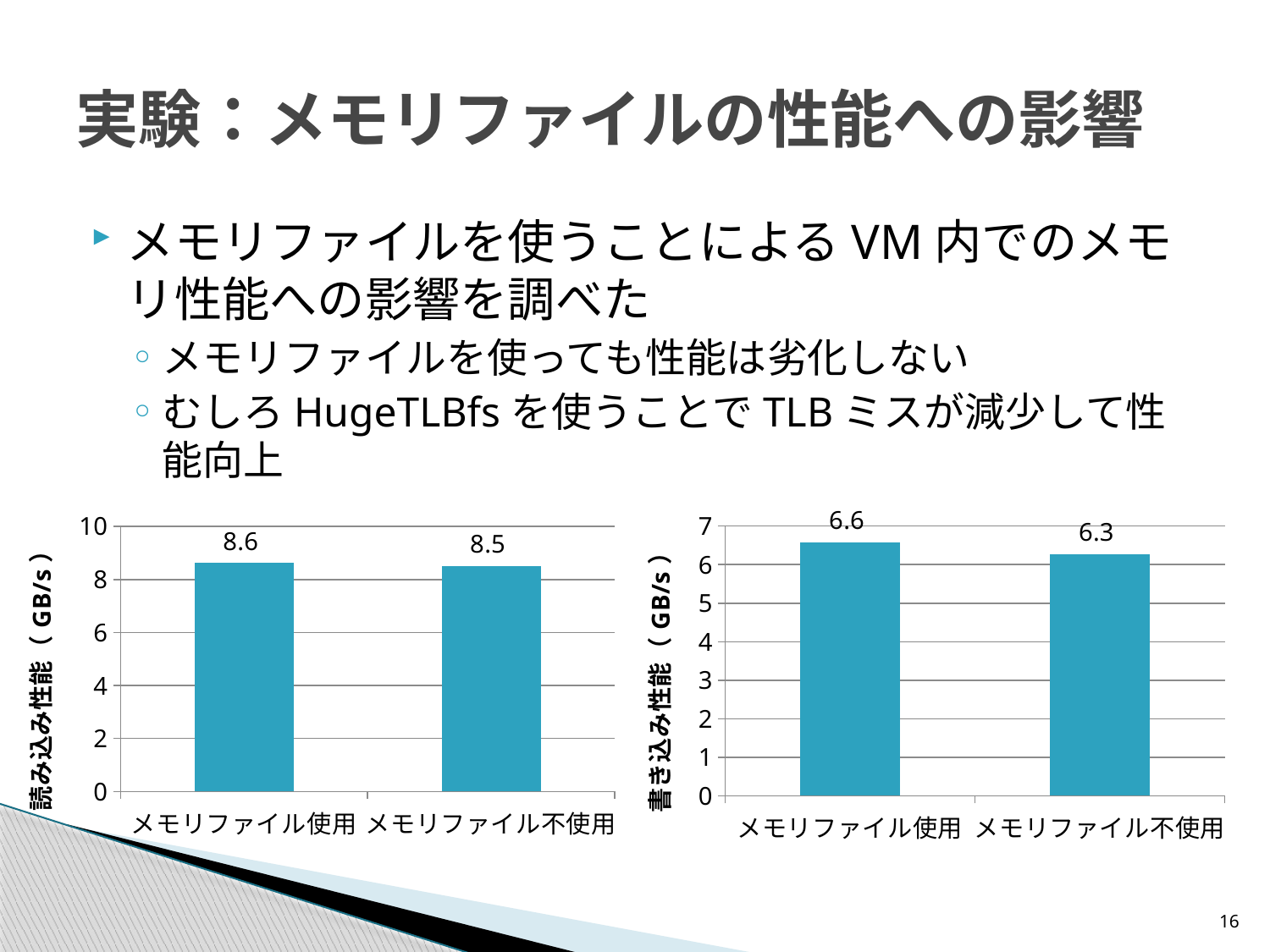
In the left chart (読み込み性能), what is the value for メモリファイル使用? 8.6 In the right chart (書き込み性能), what is the difference between メモリファイル使用 and メモリファイル不使用? 0.3 What is the y-axis label of the right chart? 書き込み性能（GB/s） In the left chart (読み込み性能), what is the value for メモリファイル不使用? 8.5 In the right chart (書き込み性能), what is the value for メモリファイル不使用? 6.3 How many categories are shown in the right chart (書き込み性能)? 2 In the left chart (読み込み性能), is the value for メモリファイル使用 greater or less than 8? greater In the right chart (書き込み性能), what is the value for メモリファイル使用? 6.6 In the right chart (書き込み性能), which category has the higher value? メモリファイル使用 In the left chart (読み込み性能), which category has the lower value? メモリファイル不使用 In the left chart (読み込み性能), what is the difference between メモリファイル使用 and メモリファイル不使用? 0.1 What kind of chart is the left chart (読み込み性能)? bar chart